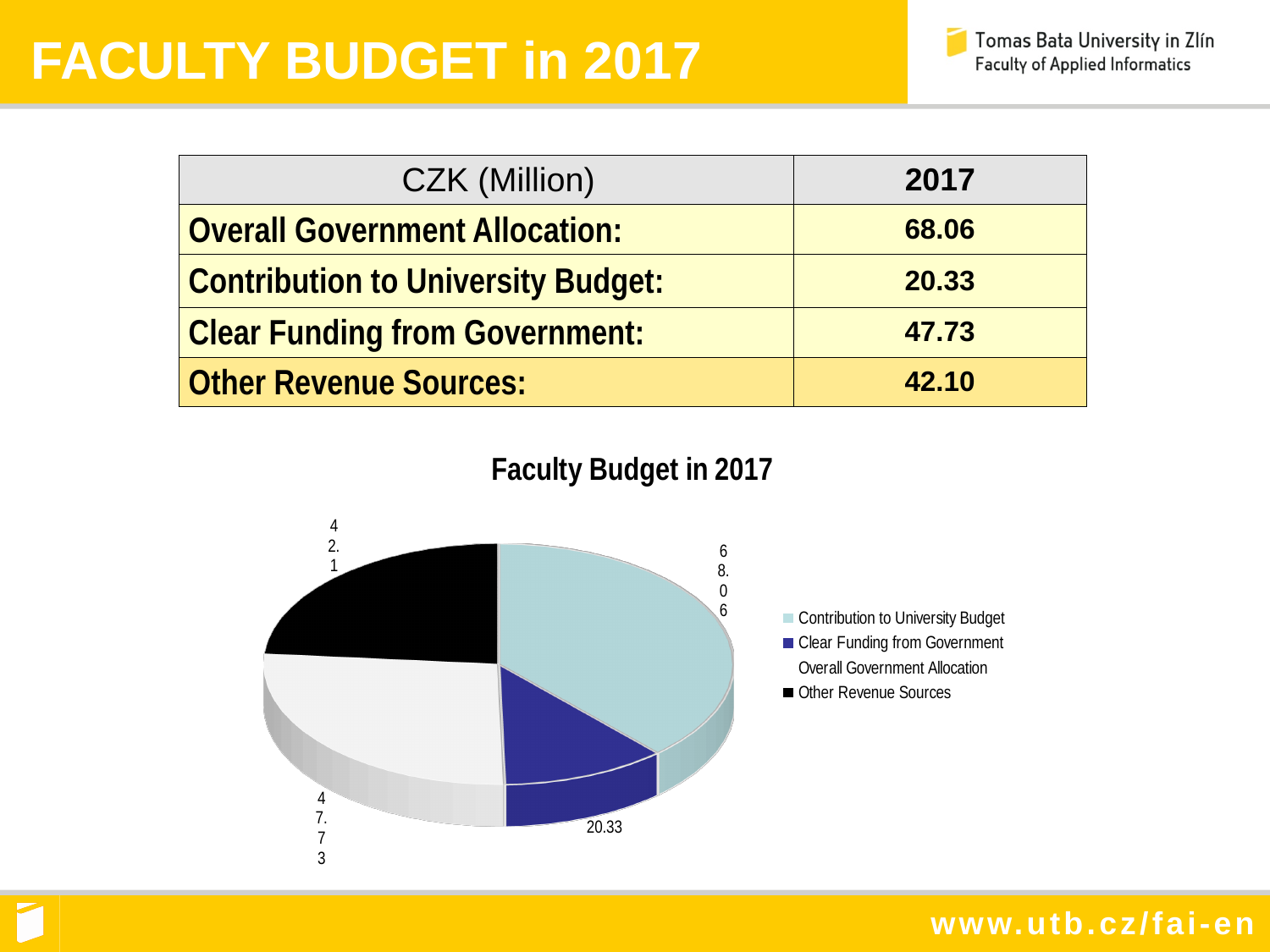
How many slices does the pie chart have? 4 On the pie chart, which is larger: the slice labelled 47.73 or the slice labelled 42.1? 47.73 What is the total of all four slice values shown on the pie chart? 178.22 What is the largest data label value shown on the pie chart? 68.06 Which legend entry of the pie chart is shown in black? Other Revenue Sources What is the smallest data label value shown on the pie chart? 20.33 How many entries does the legend of the pie chart list? 4 What is the difference between the slice labelled 47.73 and the slice labelled 42.1 on the pie chart? 5.63 Is the value of the slice labelled 20.33 on the pie chart greater or less than 30? less What is the title of the chart on the slide? Faculty Budget in 2017 What kind of chart is shown under the title "Faculty Budget in 2017"? pie chart What is the difference between the largest slice value (68.06) and the smallest slice value (20.33) on the pie chart? 47.73